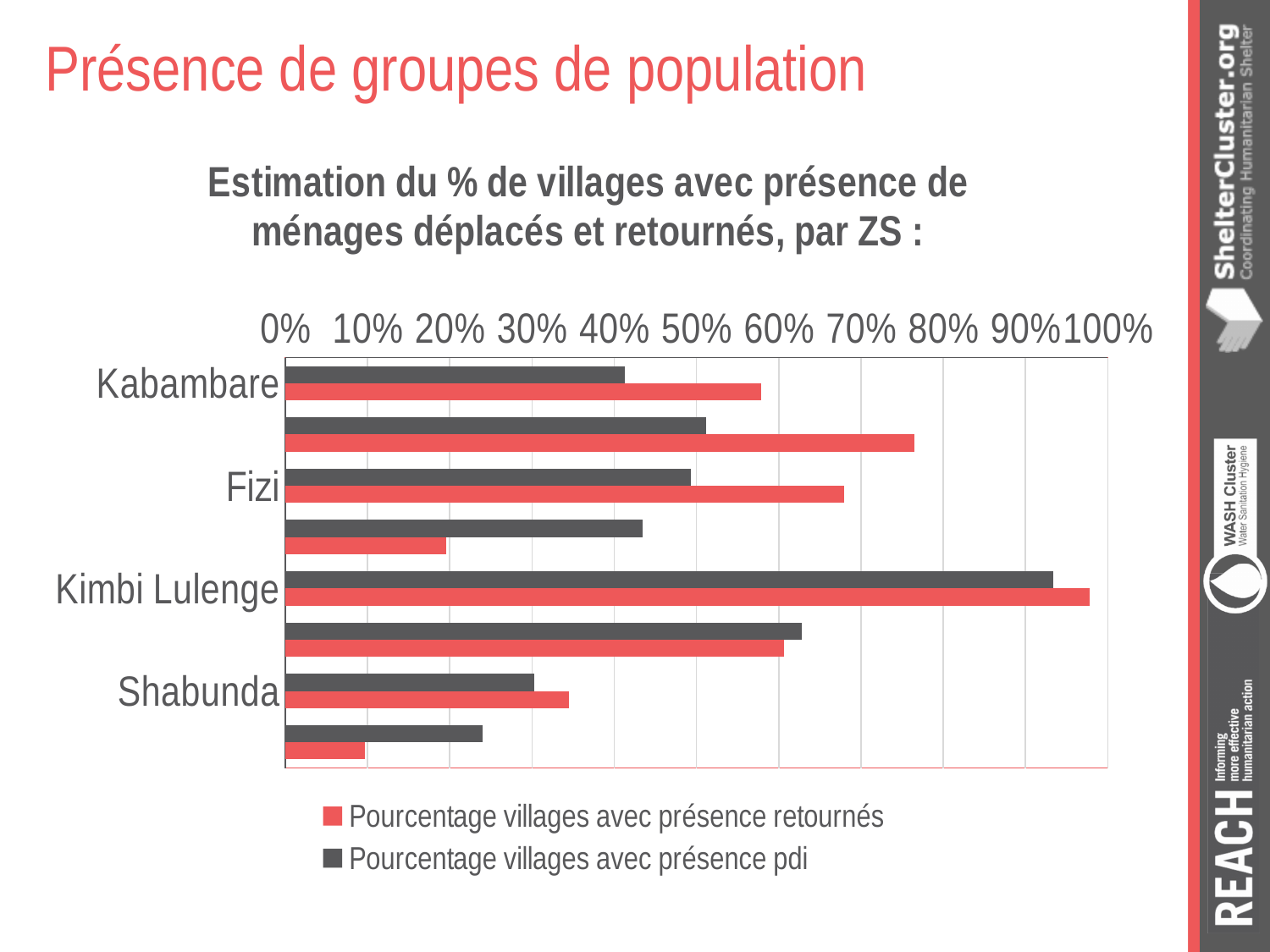
How many series does the legend list? 2 For Kabambare, which series has the larger value: 'Pourcentage villages avec présence retournés' or 'Pourcentage villages avec présence pdi'? Pourcentage villages avec présence retournés Is the value for Kabambare in the 'Pourcentage villages avec présence pdi' series greater or less than 50%? less Is the value for Kabambare in the 'Pourcentage villages avec présence retournés' series greater or less than 50%? greater Is the value for Shabunda in the 'Pourcentage villages avec présence pdi' series greater or less than 40%? less For Fizi, which series has the larger value: 'Pourcentage villages avec présence retournés' or 'Pourcentage villages avec présence pdi'? Pourcentage villages avec présence retournés Which labelled zone has the highest value in the 'Pourcentage villages avec présence retournés' series? Kimbi Lulenge What kind of chart is shown on the slide? bar chart What is the title of the chart? Estimation du % de villages avec présence de ménages déplacés et retournés, par ZS : Which colour represents 'Pourcentage villages avec présence retournés' in the legend? red